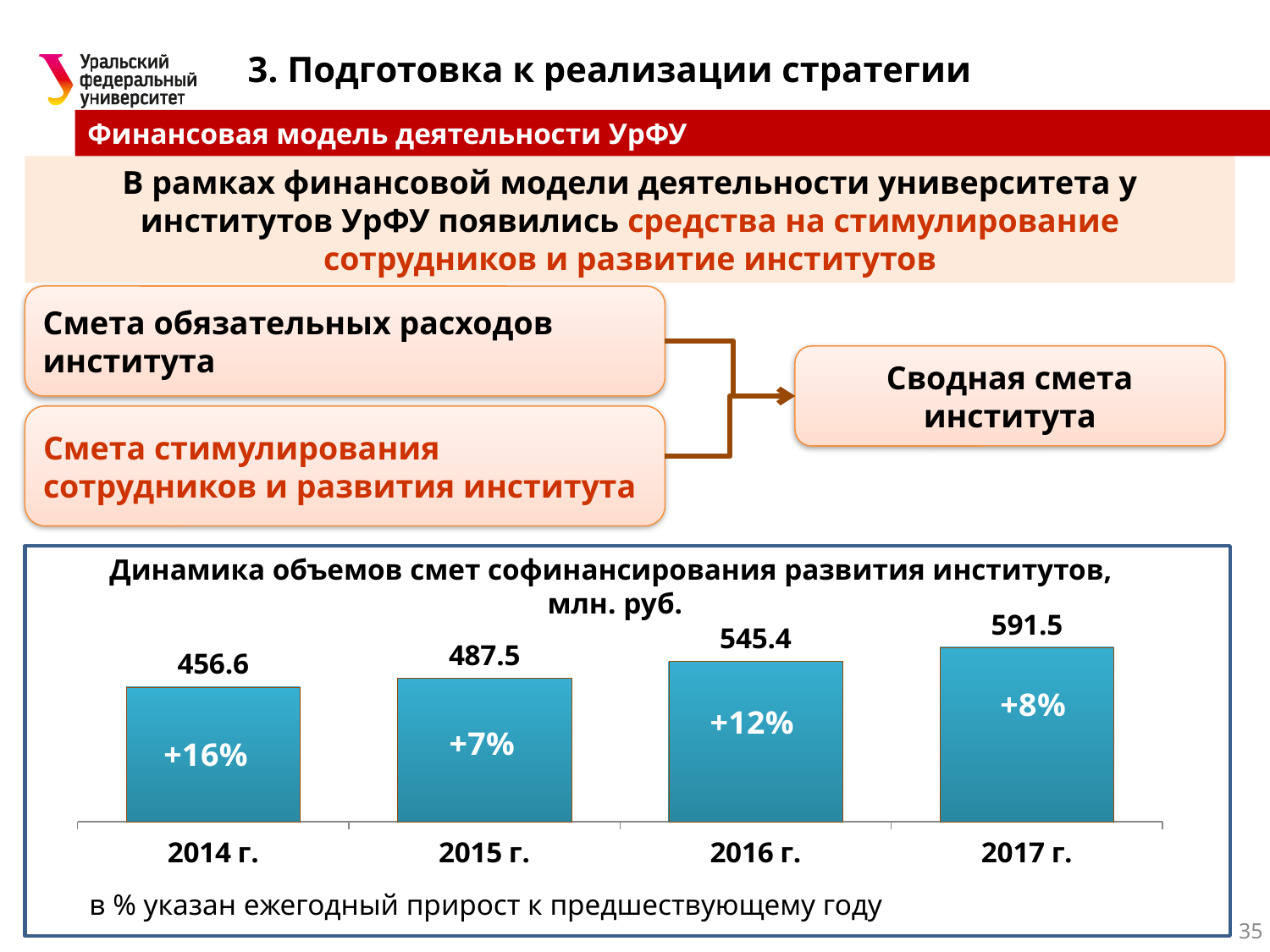
What kind of chart is shown on the slide? Bar chart What annual growth percentage is shown on the bar for 2015 г.? +7% How many years are shown in the chart? 4 What is the difference between the values for 2016 г. and 2015 г.? 57.9 Do the values rise or fall from 2014 г. to 2017 г.? Rise What annual growth percentage is shown on the bar for 2016 г.? +12% What is the value for 2014 г. in the chart? 456.6 What is the value for 2017 г. in the chart? 591.5 Which is larger, the value for 2015 г. or the value for 2016 г.? 2016 г. Which year has the lowest value in the chart? 2014 г. Which year has the highest value in the chart? 2017 г. What is the difference between the values for 2017 г. and 2014 г.? 134.9